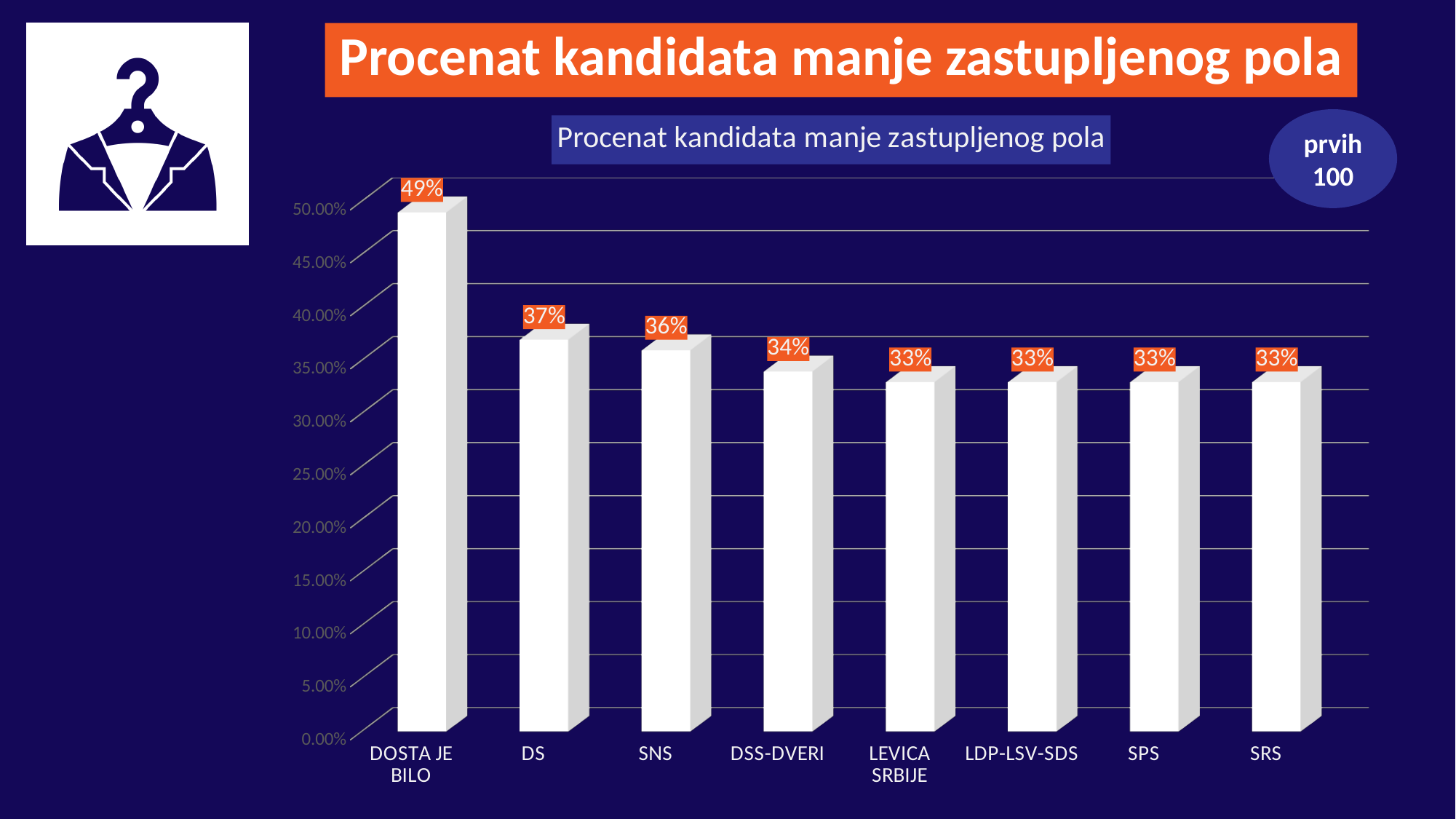
What is the value for DS? 37% What kind of chart is shown on the slide? bar chart Is the value for SRS greater or less than 30.00%? greater Which category has the highest value? DOSTA JE BILO What is the value for DSS-DVERI? 34% What is the difference between the values for DOSTA JE BILO and DS? 12% What is the value for SNS? 36% What is the value for LDP-LSV-SDS? 33% How many categories are shown on the x axis? 8 Which is larger, the value for DS or the value for DSS-DVERI? DS What is the value for DOSTA JE BILO? 49% What is the title of the chart? Procenat kandidata manje zastupljenog pola